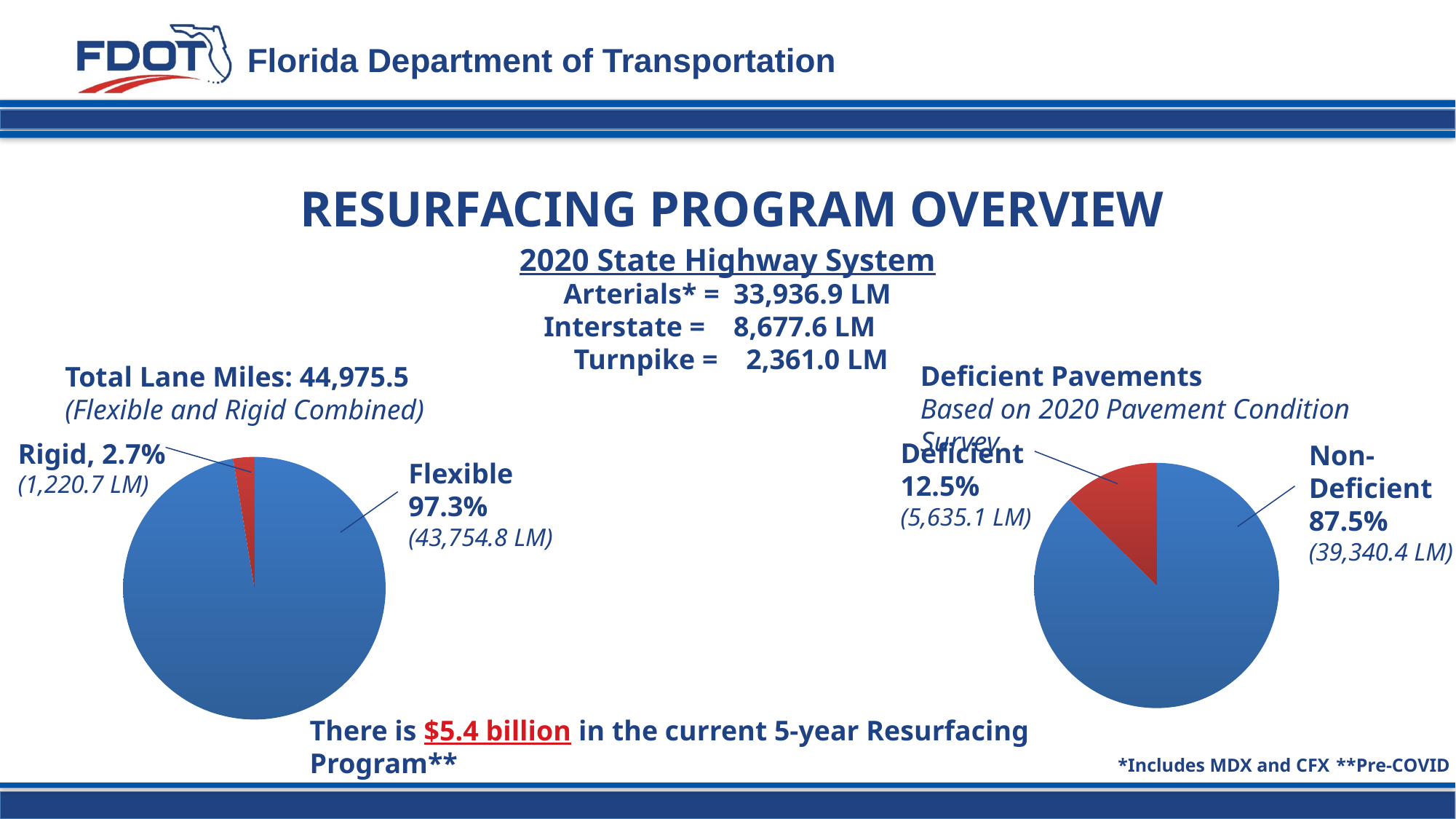
In the Total Lane Miles pie chart on the left, which slice is larger, Rigid or Flexible? Flexible In the Total Lane Miles pie chart on the left, how many lane miles are Rigid? 1,220.7 LM In the Deficient Pavements pie chart on the right, what share of pavements is Deficient? 12.5% In the Total Lane Miles pie chart on the left, what share of lane miles is Flexible? 97.3% In the Total Lane Miles pie chart on the left, what share of lane miles is Rigid? 2.7% How many slices does the Deficient Pavements pie chart on the right have? 2 In the Deficient Pavements pie chart on the right, how many lane miles are Deficient? 5,635.1 LM In the Deficient Pavements pie chart on the right, which slice is the largest? Non-Deficient In the Deficient Pavements pie chart on the right, what is the difference in percentage points between Non-Deficient and Deficient? 75 percentage points In the Deficient Pavements pie chart on the right, how many lane miles are Non-Deficient? 39,340.4 LM In the Total Lane Miles pie chart on the left, how many lane miles are Flexible? 43,754.8 LM What type of chart is used for the Total Lane Miles chart on the left? Pie chart